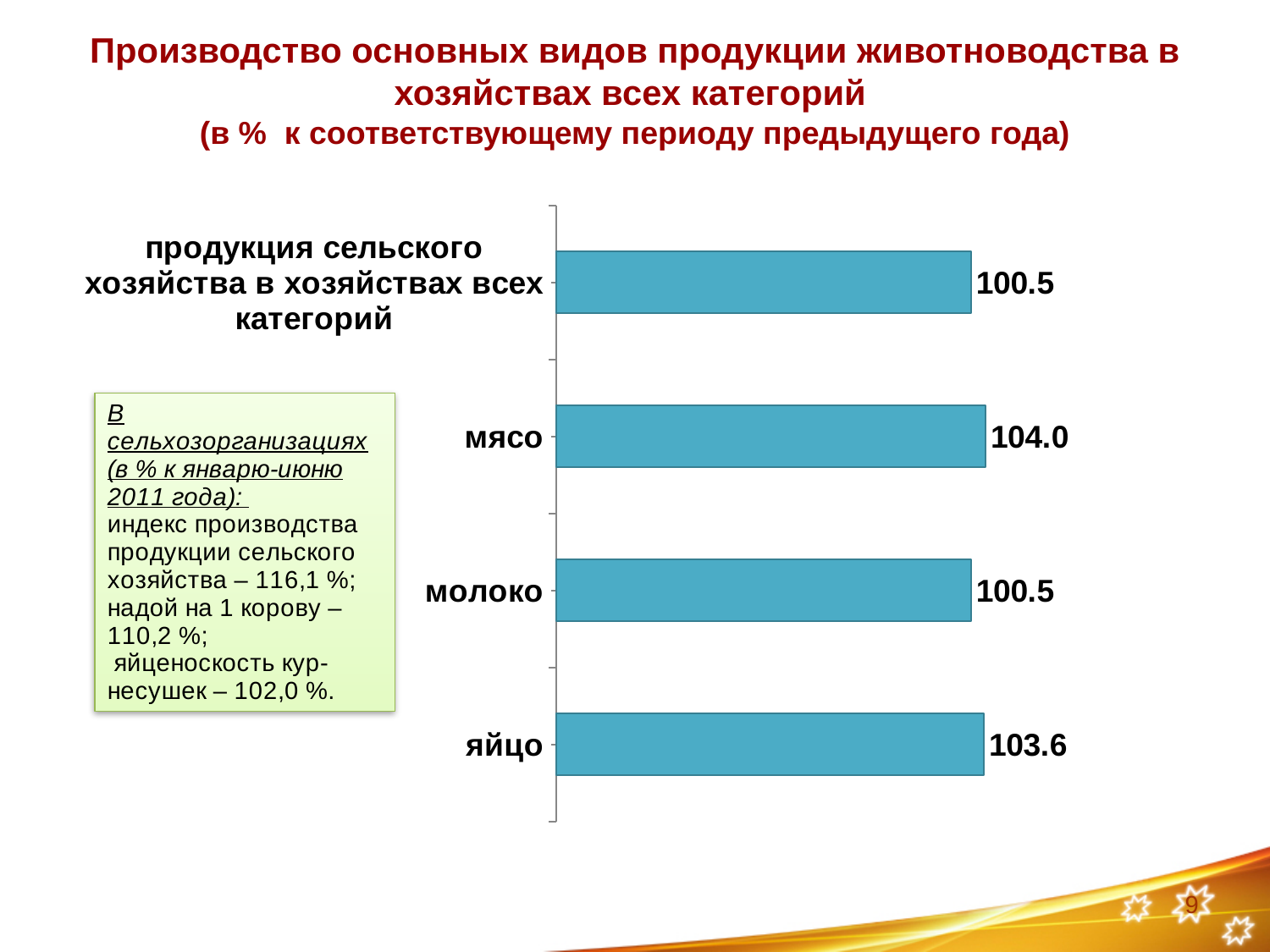
What is the value for мясо? 104.0 Which is larger, the value for мясо or the value for яйцо? мясо What colour are the bars in the chart? blue What is the difference between the values for мясо and молоко? 3.5 What kind of chart is shown on the slide? bar chart What is the value for продукция сельского хозяйства в хозяйствах всех категорий? 100.5 Which category has the highest value? мясо What is the value for молоко? 100.5 Which is larger, the value for яйцо or the value for молоко? яйцо How many categories are shown in the chart? 4 What is the difference between the values for яйцо and молоко? 3.1 What is the value for яйцо? 103.6